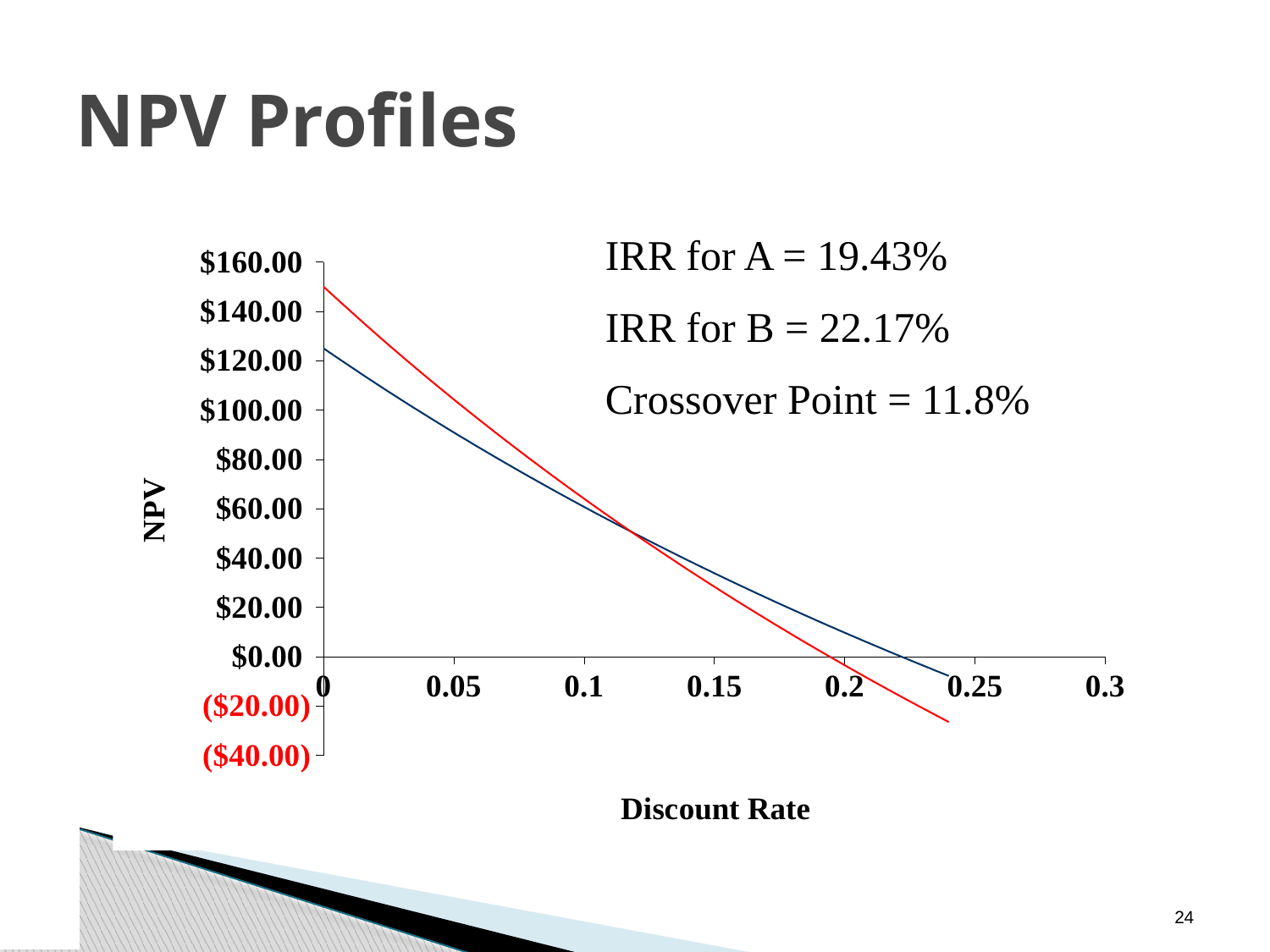
Is the NPV of the blue line at a discount rate of 0 greater or less than $140.00? less Is the NPV of the blue line at a discount rate of 0.15 greater or less than $60.00? less Is the NPV of the red line at a discount rate of 0 greater or less than $140.00? greater How many lines are plotted on the chart? 2 What kind of chart is shown on the slide? line chart At a discount rate of 0, which line has the higher NPV, the red line or the blue line? red line At a discount rate of 0.2, which line has the higher NPV, the red line or the blue line? blue line What is the title of the y axis of the chart? NPV Do the NPV values rise or fall as the discount rate increases along the x axis? fall What is the title of the x axis of the chart? Discount Rate